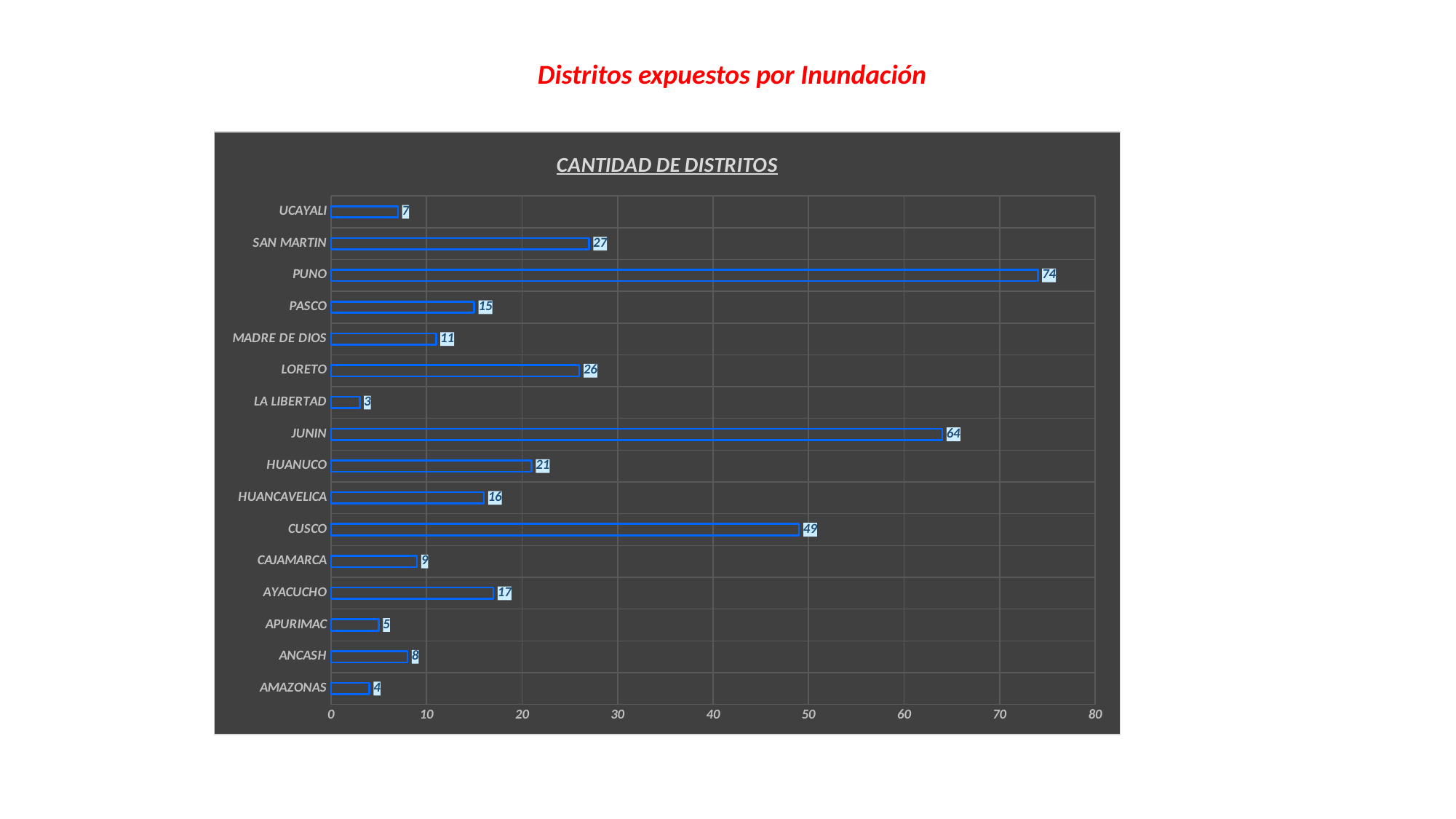
What kind of chart is shown on the slide? bar chart What is the difference between the values for AYACUCHO and APURIMAC? 12 What is the value for LA LIBERTAD? 3 How many categories are shown in the chart? 16 Is the value for HUANUCO greater or less than 20? greater Which is larger, the value for SAN MARTIN or the value for LORETO? SAN MARTIN What is the difference between the values for PUNO and JUNIN? 10 Which category has the highest value? PUNO What is the value for PUNO? 74 What is the title of the chart? CANTIDAD DE DISTRITOS Which category has the lowest value? LA LIBERTAD What is the value for CUSCO? 49